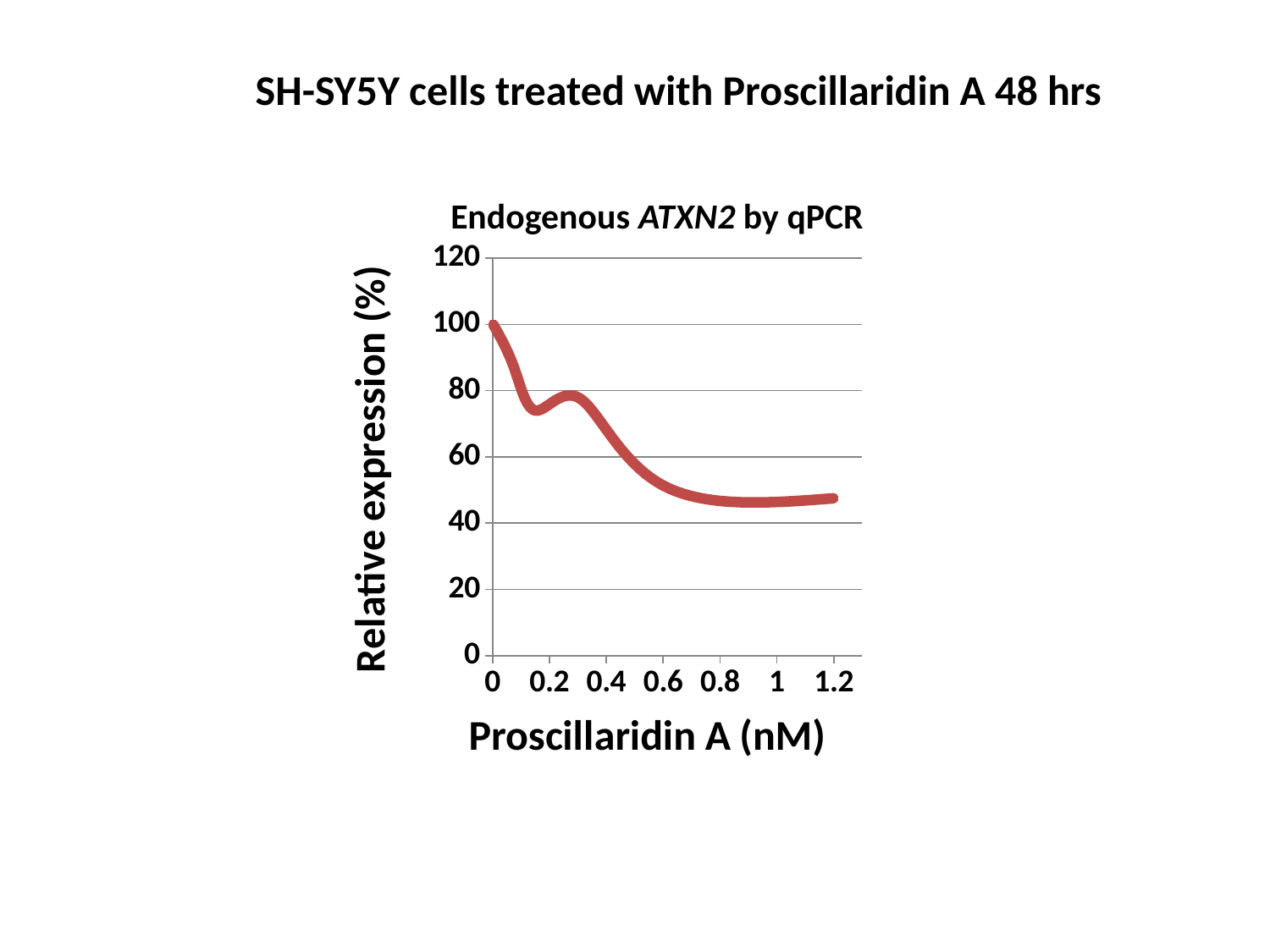
What kind of chart is shown on the slide? line chart What is the title of the chart? Endogenous ATXN2 by qPCR Is the relative expression at 1.2 nM greater or less than 40? greater At which Proscillaridin A concentration is relative expression highest? 0 Is the relative expression at 0.6 nM greater or less than 60? less Does relative expression generally rise or fall as Proscillaridin A concentration increases? fall Which has the higher relative expression, 0 nM or 1 nM Proscillaridin A? 0 nM Is the relative expression at 0.4 nM greater or less than 60? greater What is the relative expression at 0 nM Proscillaridin A? 100 What is the label of the y axis? Relative expression (%)